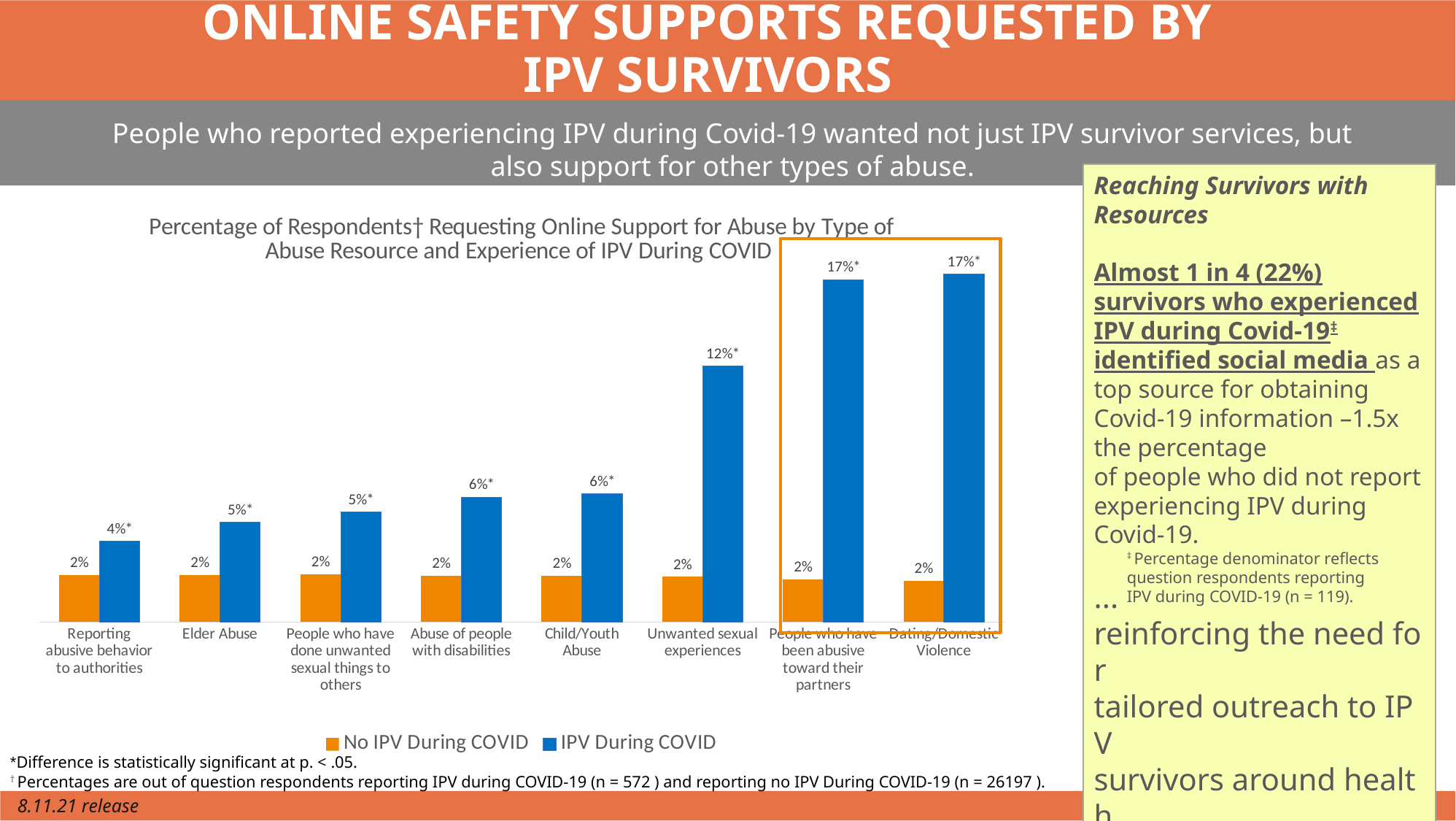
Which series is shown in orange in the legend? No IPV During COVID Which category has the lowest IPV During COVID value? Reporting abusive behavior to authorities What is the value for IPV During COVID for Elder Abuse? 5% What is the value for IPV During COVID for Reporting abusive behavior to authorities? 4% Which is larger for Abuse of people with disabilities: the IPV During COVID value or the No IPV During COVID value? IPV During COVID How many categories of abuse resource are shown on the x axis? 8 What is the value for IPV During COVID for Unwanted sexual experiences? 12% How many series does the legend list? 2 Do the IPV During COVID values generally rise or fall from left to right along the x axis? rise What is the difference between the IPV During COVID and No IPV During COVID values for Dating/Domestic Violence? 15% What type of chart is shown on the slide? bar chart What is the value for No IPV During COVID for Child/Youth Abuse? 2%